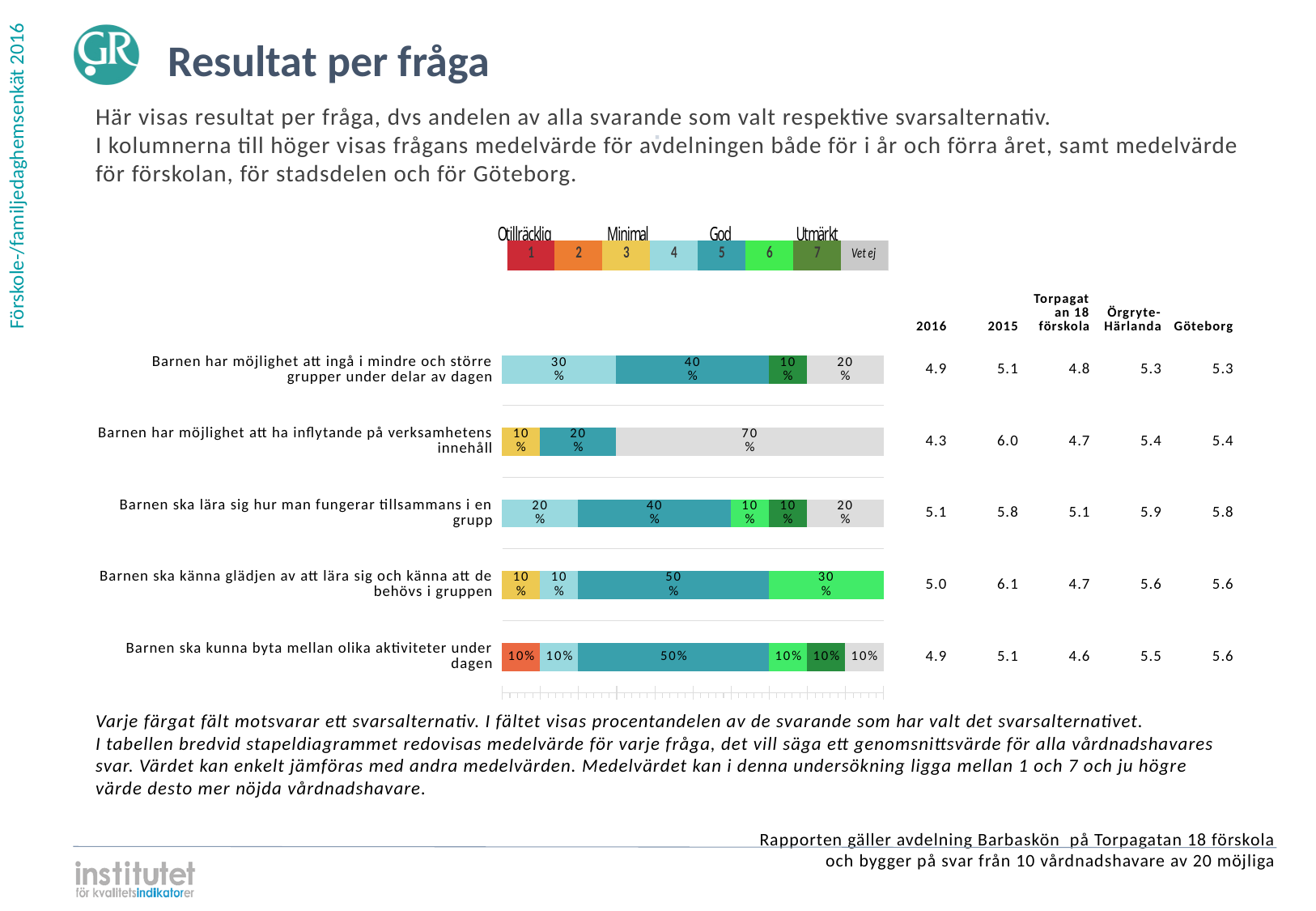
What kind of chart is used to show the results per question? Stacked bar chart Which question has the largest 'Vet ej' share? Barnen har möjlighet att ha inflytande på verksamhetens innehåll What is the difference between the 'Vet ej' share for 'Barnen har möjlighet att ha inflytande på verksamhetens innehåll' and for 'Barnen ska lära sig hur man fungerar tillsammans i en grupp'? 50 percentage points What is the largest segment in the bar for 'Barnen ska kunna byta mellan olika aktiviteter under dagen'? 50% What percentage chose answer 6 (light green) for 'Barnen ska känna glädjen av att lära sig och känna att de behövs i gruppen'? 30% Is the 2015 mean for 'Barnen ska känna glädjen av att lära sig och känna att de behövs i gruppen' larger than its 2016 mean? Yes, 6.1 vs 5.0 What is the 2016 mean value for 'Barnen ska lära sig hur man fungerar tillsammans i en grupp'? 5.1 What percentage chose answer 5 for 'Barnen har möjlighet att ingå i mindre och större grupper under delar av dagen'? 40% Which question has the lowest 2016 mean value? Barnen har möjlighet att ha inflytande på verksamhetens innehåll What percentage of respondents answered 'Vet ej' for 'Barnen har möjlighet att ha inflytande på verksamhetens innehåll'? 70% How many questions (bars) are shown in the chart? 5 How many answer categories does the legend show, including 'Vet ej'? 8